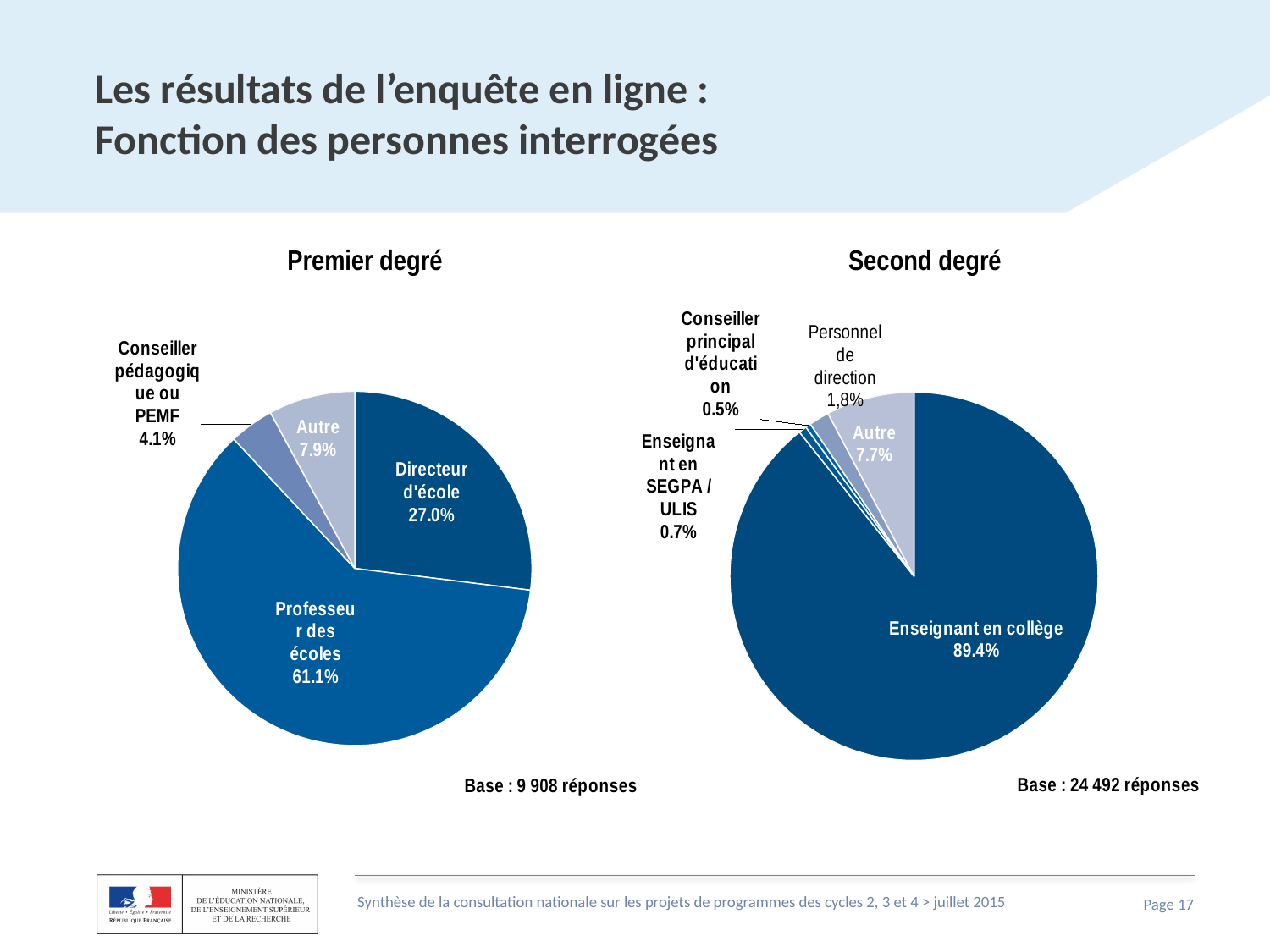
In the Premier degré chart, what share is labelled for Professeur des écoles? 61.1% In the Second degré chart, what share is labelled for Enseignant en SEGPA / ULIS? 0.7% In the Premier degré chart, which category has the smallest share? Conseiller pédagogique ou PEMF What is the base (number of responses) stated under the Second degré chart? 24 492 réponses In the Premier degré chart, what share is labelled for Directeur d'école? 27.0% In the Premier degré chart, how many slices does the pie have? 4 Which is larger: the Autre share in the Premier degré chart or the Autre share in the Second degré chart? Premier degré In the Second degré chart, which category has the smallest share? Conseiller principal d'éducation In the Second degré chart, how many slices does the pie have? 5 What kind of chart is used for the Second degré data? Pie chart In the Second degré chart, what share is labelled for Enseignant en collège? 89.4% In the Premier degré chart, what is the difference in percentage points between Professeur des écoles and Directeur d'école? 34.1